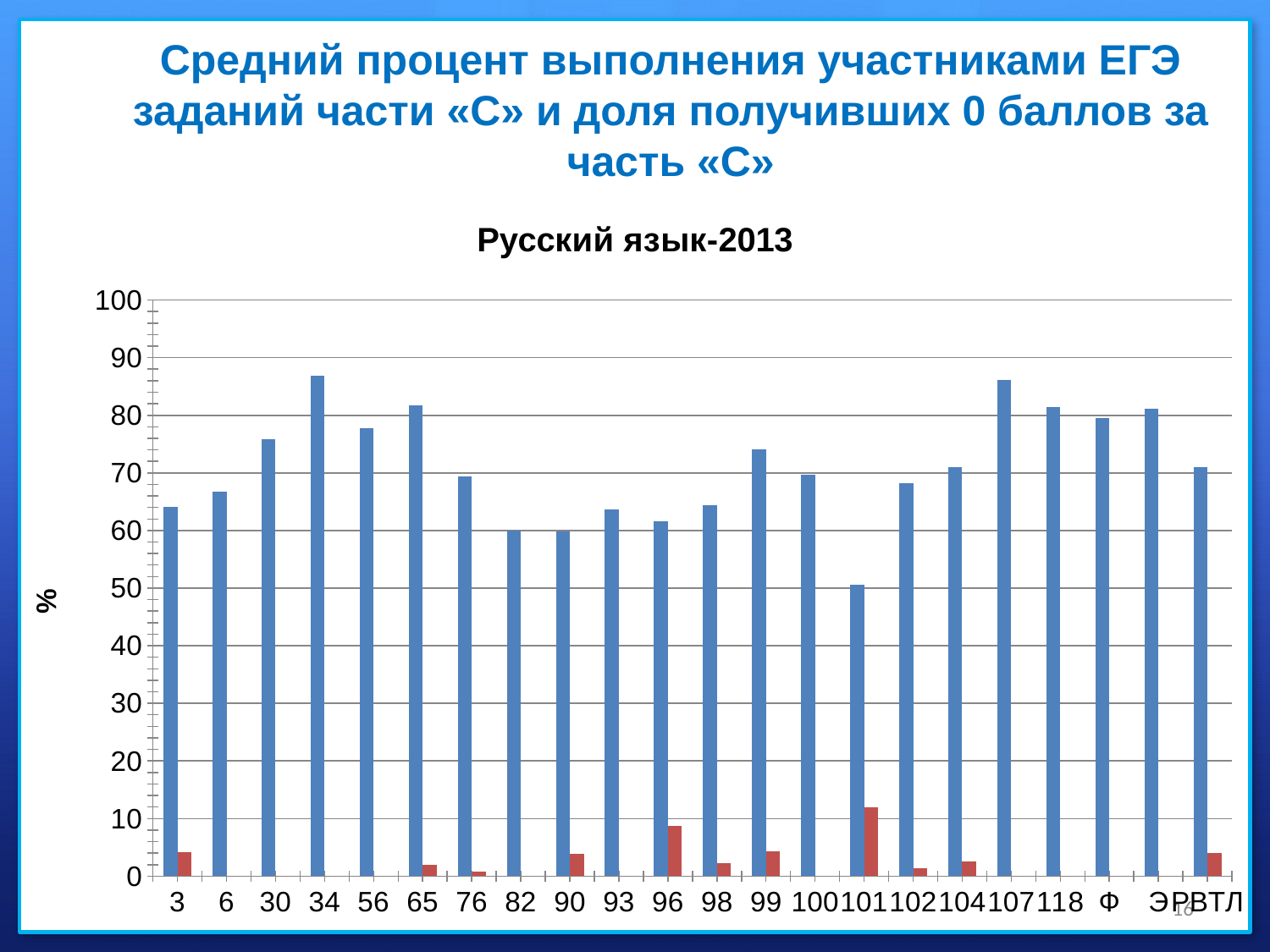
Which category has the lowest blue bar? 101 Which category has the tallest red bar? 101 Which has the taller blue bar, category 34 or category 3? 34 What kind of chart is shown on the slide? bar chart Which has the taller blue bar, category 30 or category 82? 30 Is the blue bar for category 101 greater or less than 60? less Which has the taller blue bar, category 65 or category 76? 65 Is the blue bar for category 99 greater or less than 70? greater Is the blue bar for category 34 greater or less than 80? greater What is the label on the vertical axis of the chart? % What is the title of the chart? Русский язык-2013